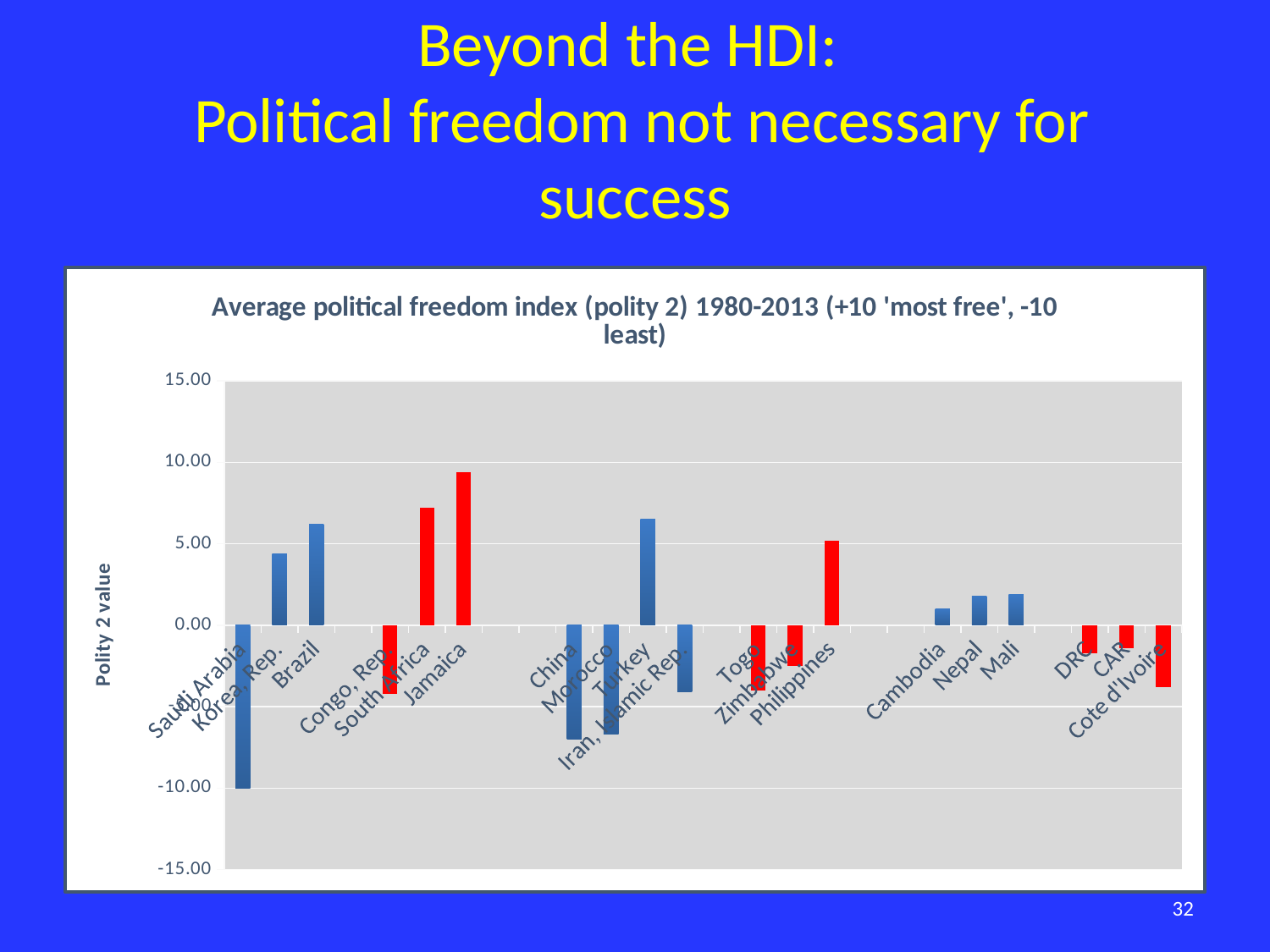
Which country has the lowest average political freedom index in the chart? Saudi Arabia Is the value for China greater or less than -5.00? less Is the value for Turkey greater or less than 5.00? greater Is the value for Jamaica greater or less than 5.00? greater Which has the higher value, Jamaica or South Africa? Jamaica Which has the higher value, Brazil or Korea, Rep.? Brazil What kind of chart is shown on the slide? Bar chart What is the label on the vertical axis of the chart? Polity 2 value How many countries are plotted in the chart? 19 Which country has the highest average political freedom index in the chart? Jamaica